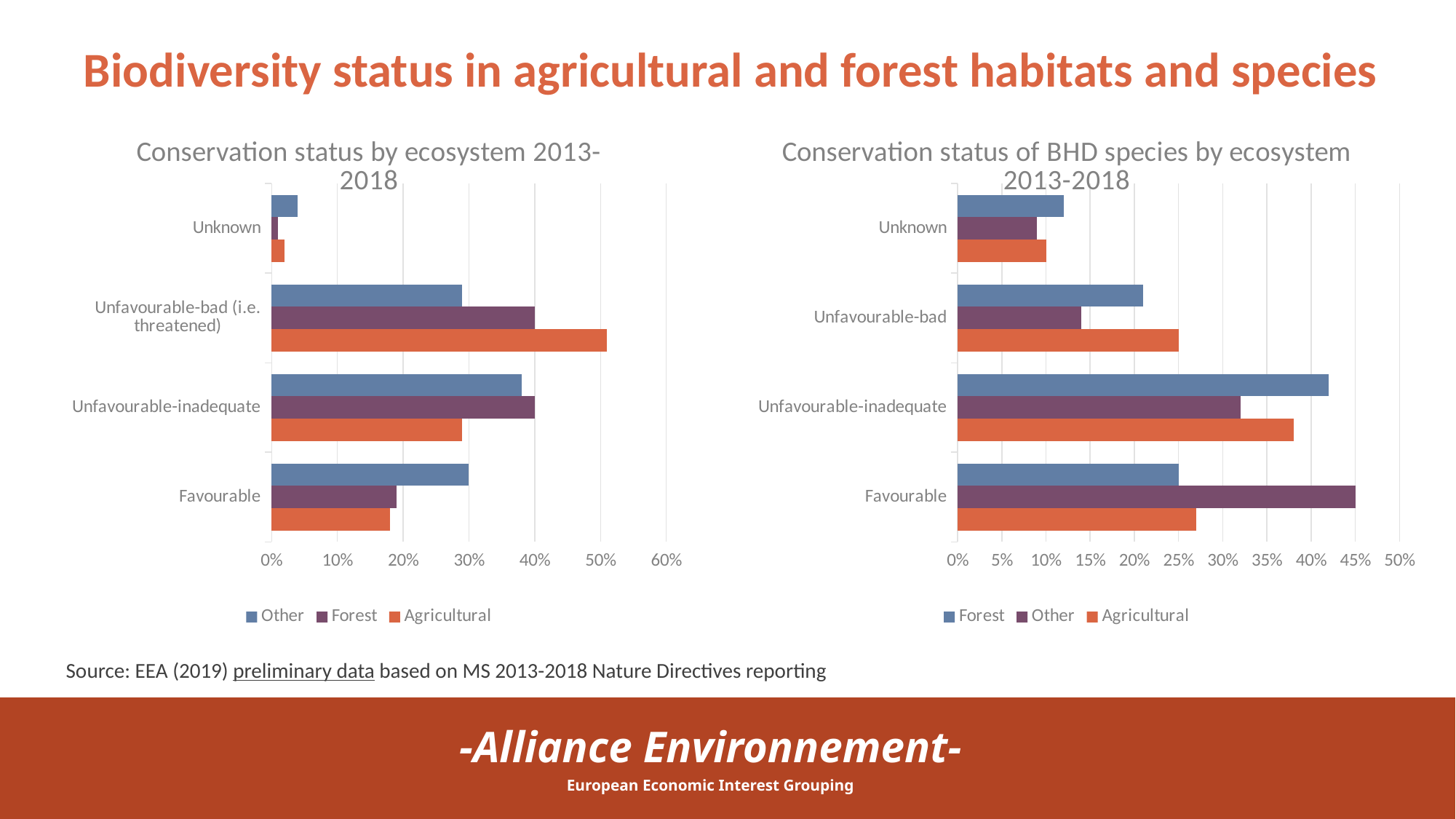
In the chart titled "Conservation status of BHD species by ecosystem 2013-2018", which is larger for Unfavourable-bad: Agricultural or Other? Agricultural How many categories are shown on the y axis of the chart titled "Conservation status by ecosystem 2013-2018"? 4 In the chart titled "Conservation status by ecosystem 2013-2018", which series has the lowest value for Unknown? Forest In the chart titled "Conservation status of BHD species by ecosystem 2013-2018", which series has the highest value for Favourable? Other How many series does the legend list in the chart titled "Conservation status of BHD species by ecosystem 2013-2018"? 3 In the chart titled "Conservation status by ecosystem 2013-2018", which series has the highest value for Unfavourable-bad (i.e. threatened)? Agricultural In the chart titled "Conservation status of BHD species by ecosystem 2013-2018", is the Forest value for Unfavourable-inadequate greater or less than 40%? greater In the chart titled "Conservation status by ecosystem 2013-2018", is the Other value for Favourable greater or less than 20%? greater In the chart titled "Conservation status by ecosystem 2013-2018", which is larger for Favourable: Other or Forest? Other In the chart titled "Conservation status by ecosystem 2013-2018", is the Agricultural value for Unfavourable-bad (i.e. threatened) greater or less than 40%? greater What kind of chart is the chart titled "Conservation status of BHD species by ecosystem 2013-2018"? Bar chart